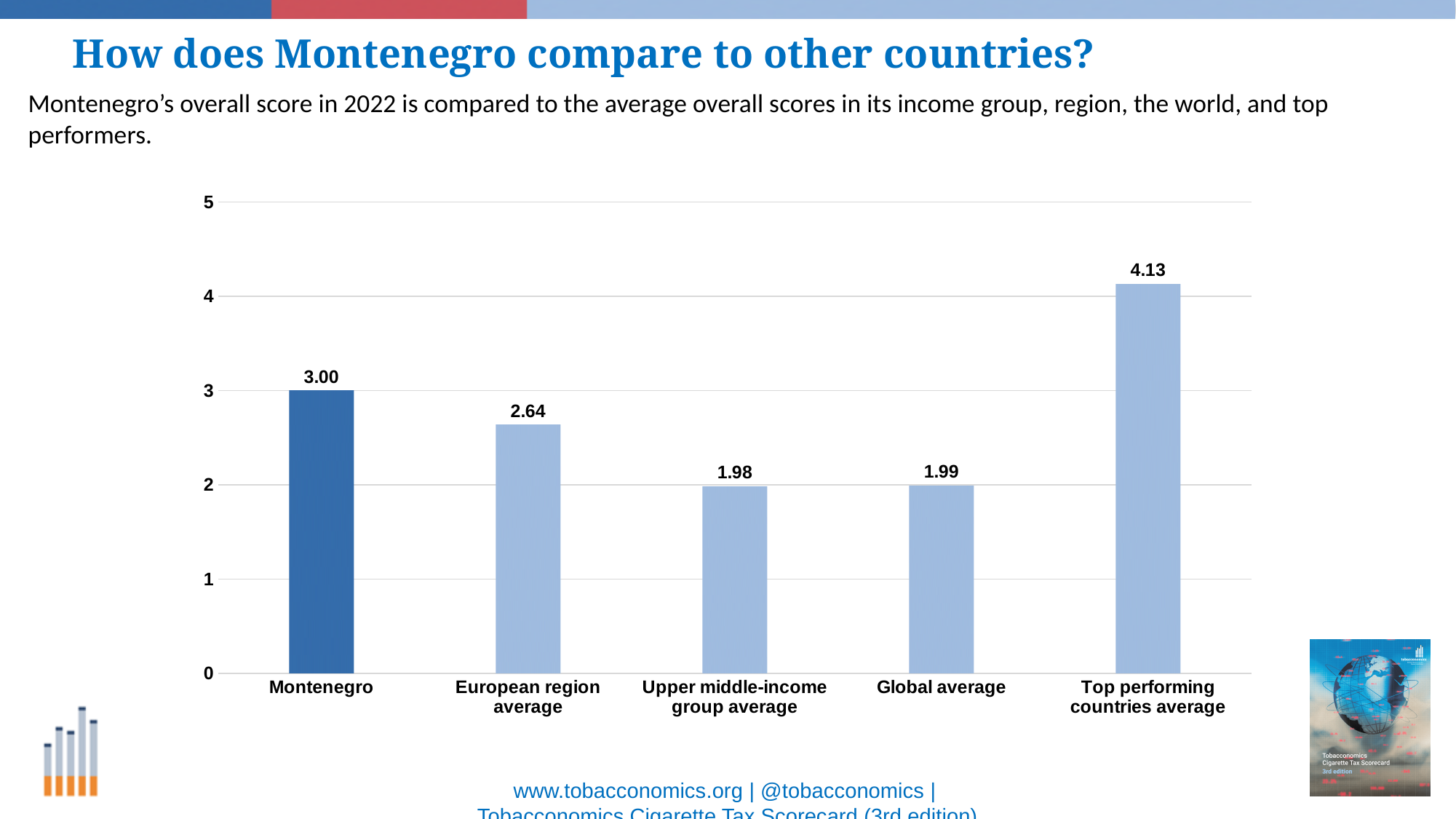
Is the value for the Top performing countries average greater or less than 4? greater What is the value for the Top performing countries average? 4.13 What is the difference between the Top performing countries average and Montenegro? 1.13 What is the value for the Global average? 1.99 What is the value for the European region average? 2.64 What is the difference between Montenegro and the European region average? 0.36 What kind of chart is shown on the slide? bar chart Which category has the highest value? Top performing countries average What is the value for Montenegro? 3.00 How many categories are shown on the x axis? 5 Which bar is shown in a darker blue than the others? Montenegro Which is larger, Montenegro or the European region average? Montenegro